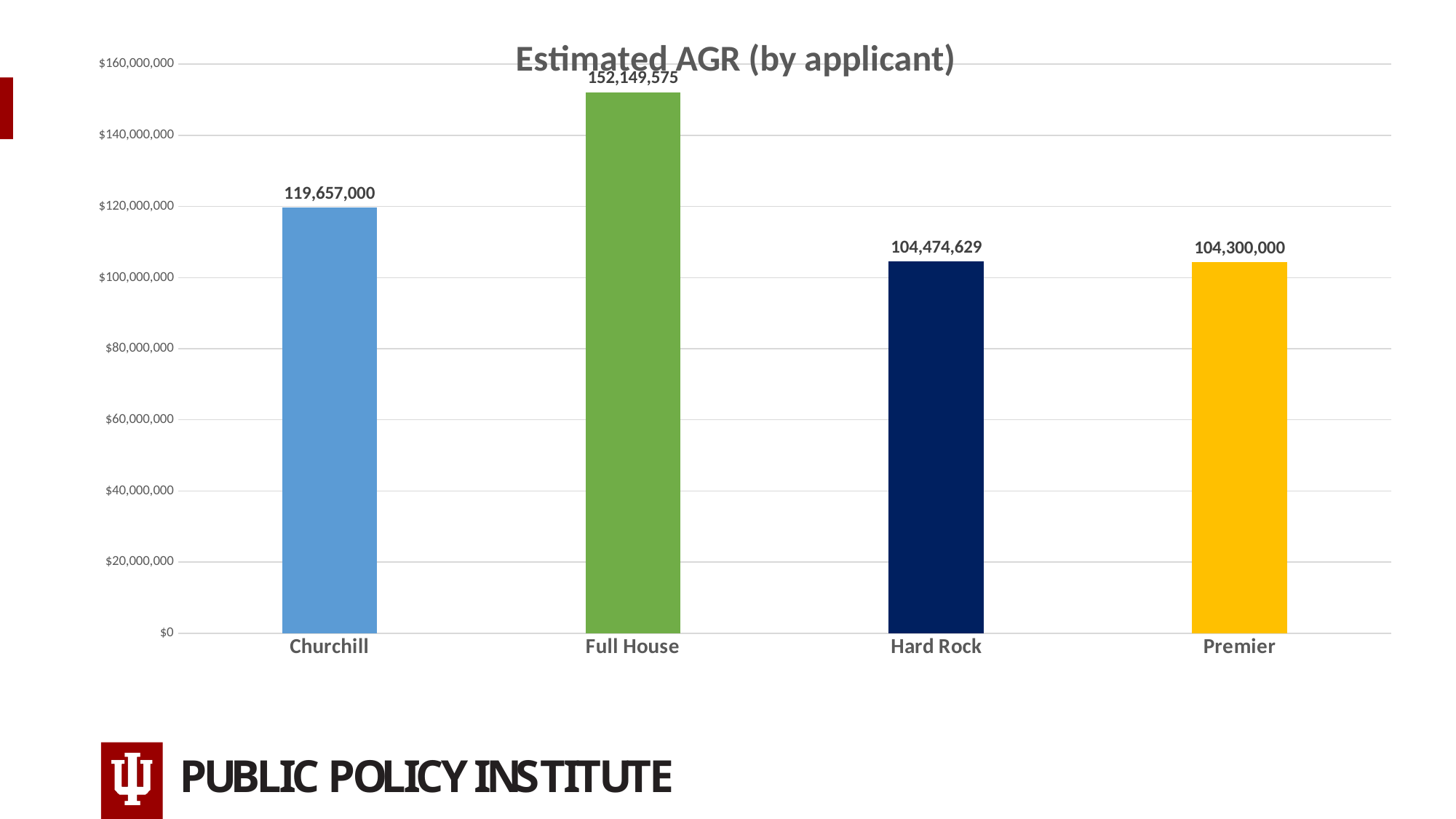
What is the difference between the estimated AGR of Full House and Churchill? 32,492,575 What kind of chart is shown on the slide? bar chart Which has a larger estimated AGR, Churchill or Hard Rock? Churchill What is the estimated AGR for Premier? 104,300,000 What is the estimated AGR for Full House? 152,149,575 What is the estimated AGR for Hard Rock? 104,474,629 Is the estimated AGR for Full House greater or less than $140,000,000? greater How many applicants are shown in the chart? 4 What is the estimated AGR for Churchill? 119,657,000 What is the title of the chart? Estimated AGR (by applicant) Which applicant has the highest estimated AGR? Full House What is the difference between the estimated AGR of Hard Rock and Premier? 174,629